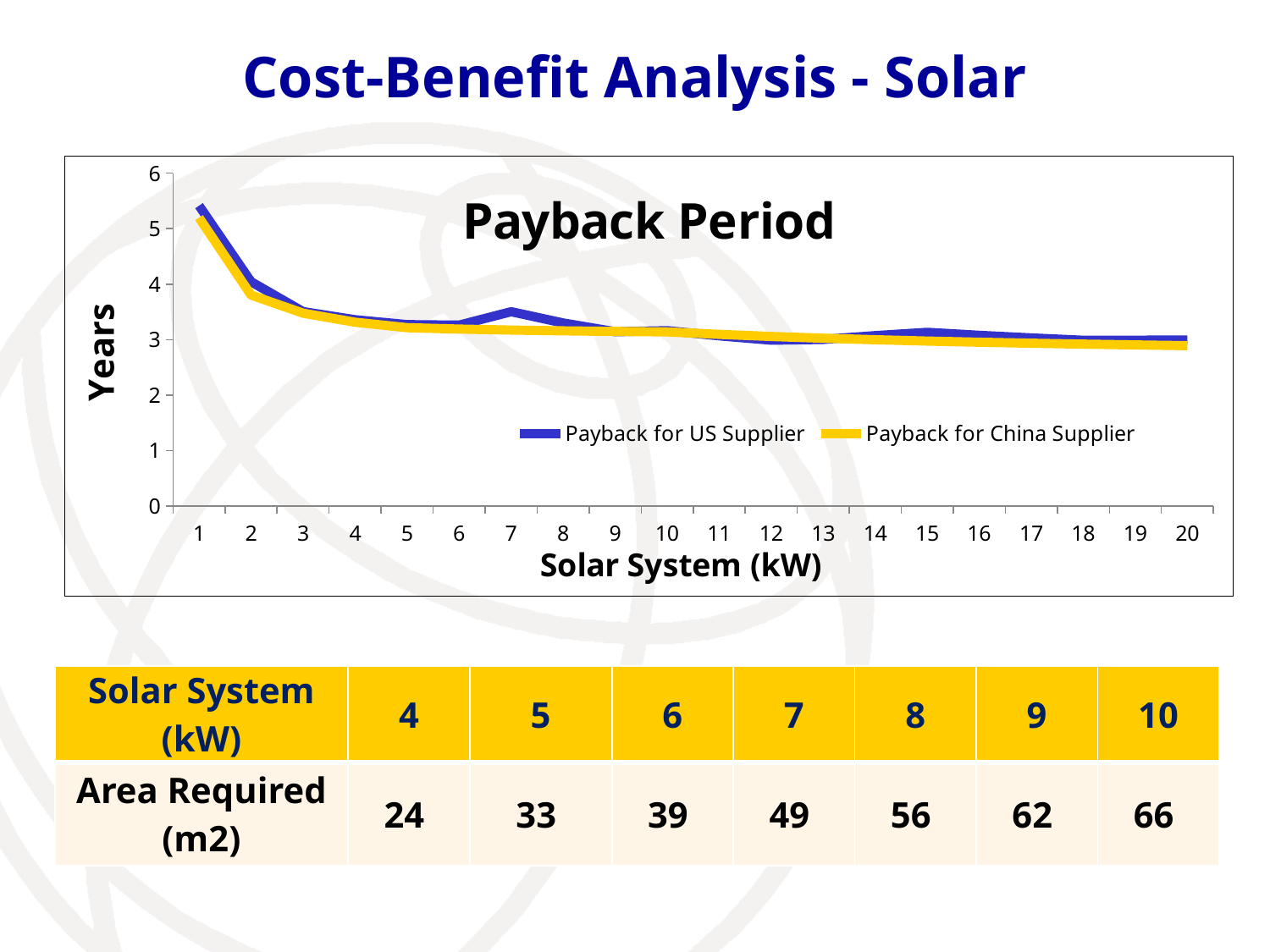
Do the payback period values generally rise or fall as the solar system size increases? fall What kind of chart is the Payback Period chart? line chart Is the payback for the China supplier at 20 kW greater or less than 4 years? less At 7 kW, which series has the higher payback period, the US supplier or the China supplier? Payback for US Supplier Is the payback for the China supplier at 10 kW greater or less than 2 years? greater At which solar system size (kW) is the payback for the US supplier highest? 1 How many series does the legend of the Payback Period chart list? 2 What is the label of the y axis on the Payback Period chart? Years Which colour represents the Payback for China Supplier series? yellow Is the payback for the US supplier at 1 kW greater or less than 5 years? greater How many solar system sizes (kW) are plotted along the x axis of the Payback Period chart? 20